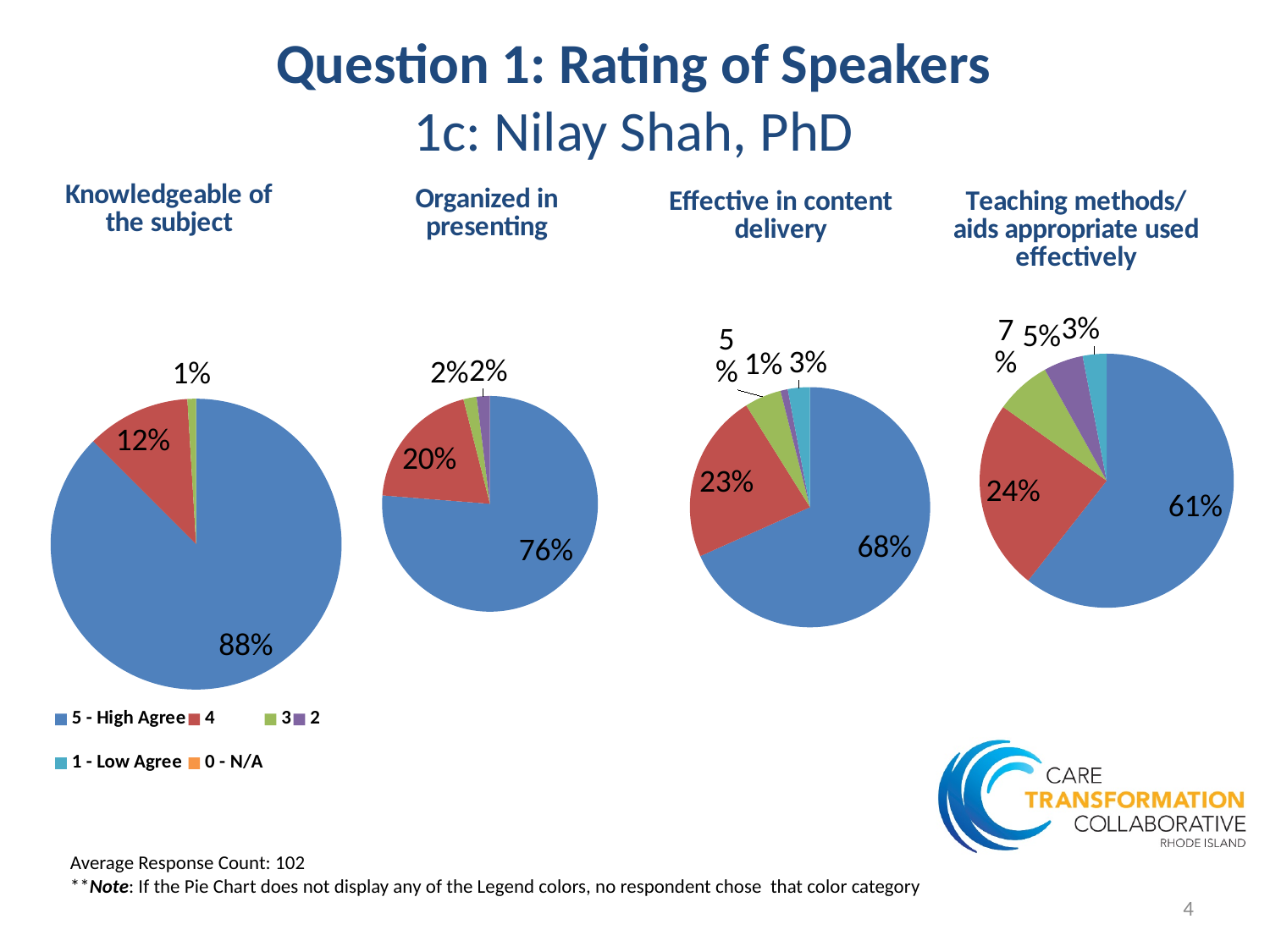
In the 'Teaching methods/aids appropriate used effectively' pie chart, which rating has the largest slice? 5 - High Agree How many categories does the legend list? 6 How many slices does the 'Effective in content delivery' pie chart have? 5 In the 'Effective in content delivery' pie chart, what percentage is shown for '5 - High Agree'? 68% In the 'Knowledgeable of the subject' pie chart, what is the difference between the '5 - High Agree' share and the '4' share? 76% Which chart shows a larger share for '5 - High Agree': 'Organized in presenting' or 'Teaching methods/aids appropriate used effectively'? Organized in presenting How many pie charts are shown on the slide? 4 In the 'Organized in presenting' pie chart, what percentage is shown for the '4' rating? 20% In the 'Teaching methods/aids appropriate used effectively' pie chart, what percentage is shown for the '3' rating? 7% In the 'Knowledgeable of the subject' pie chart, what share of respondents chose '5 - High Agree'? 88% In the 'Effective in content delivery' pie chart, which rating has the smallest slice? 2 What type of chart is used for 'Organized in presenting'? Pie chart